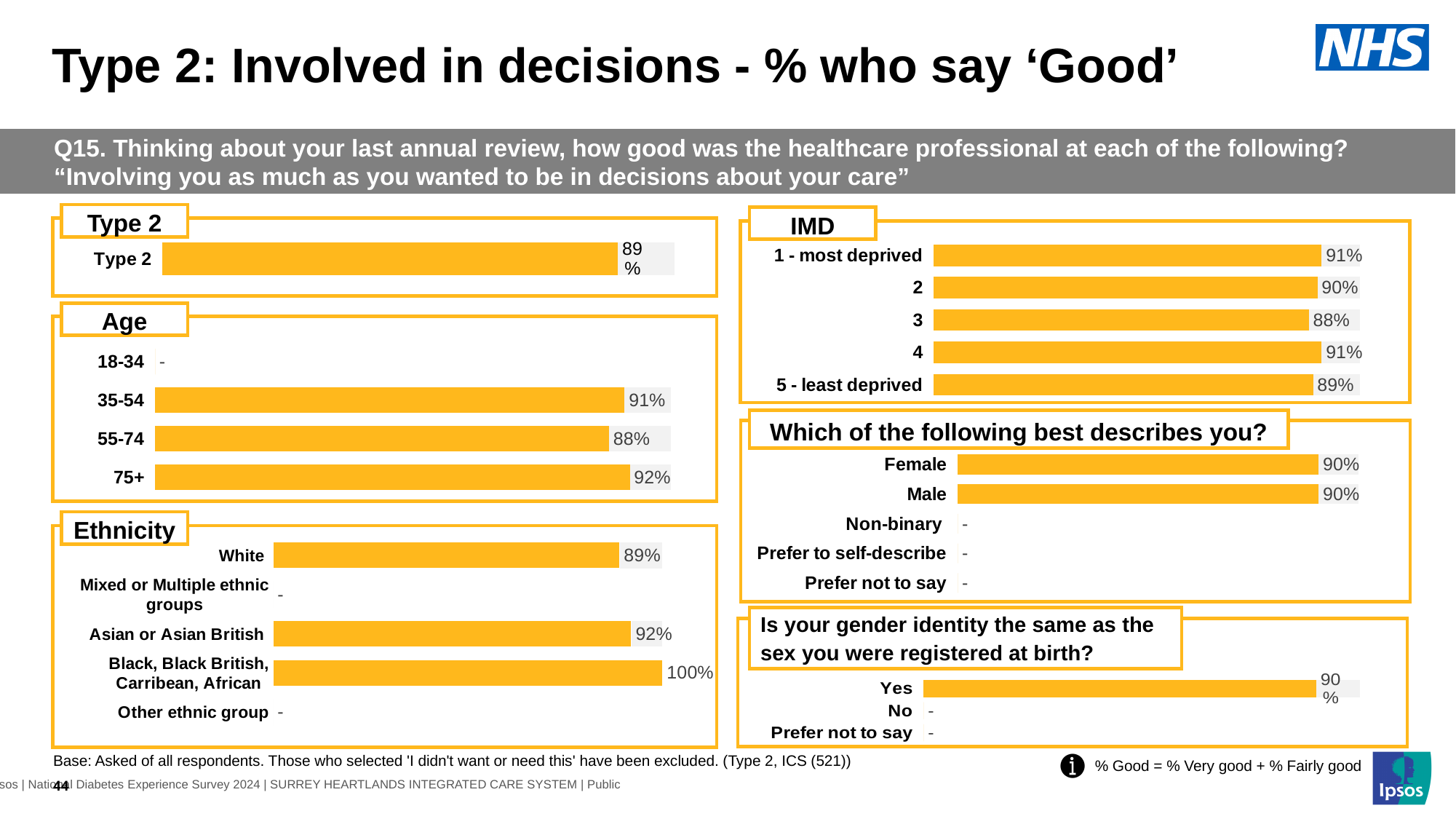
In the Ethnicity chart, what is the value for Black, Black British, Carribean, African? 100% In the IMD chart, how many categories are listed? 5 In the Age chart, which age group with a plotted value has the highest percentage? 75+ In the Ethnicity chart, which of White or Asian or Asian British has the higher value? Asian or Asian British What type of chart is used in the Age section? Bar chart In the IMD chart, which category has the lowest value? 3 In the IMD chart, what is the value for 3? 88% In the 'Which of the following best describes you?' chart, what is the value for Male? 90% In the Age chart, what is the value for the 55-74 age group? 88% In the Age chart, what is the difference between the 75+ and 55-74 values? 4 percentage points In the 'Is your gender identity the same as the sex you were registered at birth?' chart, what is the value for Yes? 90% In the Type 2 chart, what percentage of Type 2 respondents say 'Good'? 89%